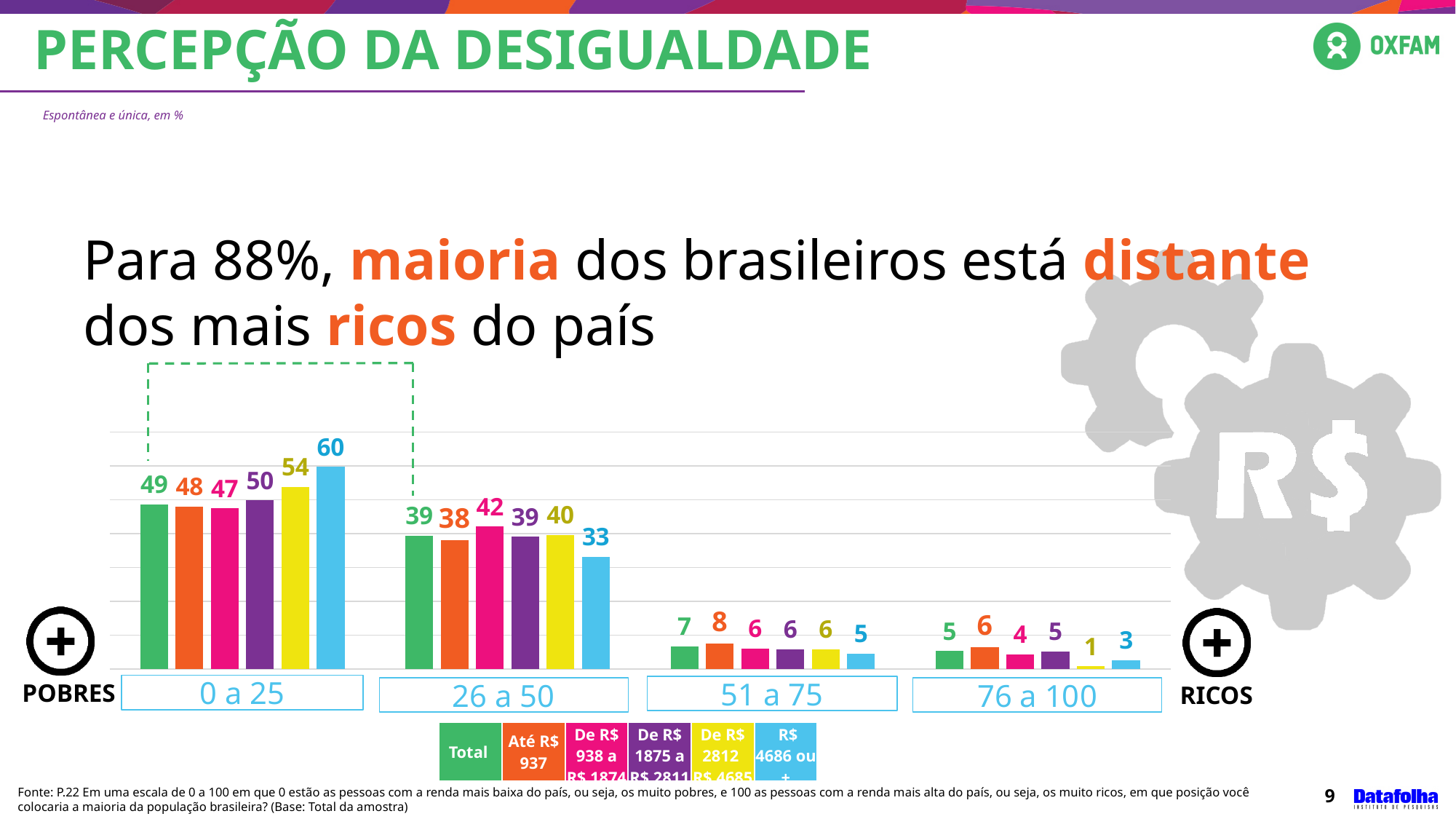
How many categories are shown on the x axis? 4 Which category has the highest Total value? 0 a 25 What is the difference between the Total values for "0 a 25" and "26 a 50"? 10 What is the Total value for the "0 a 25" category? 49 What is the value for the "Até R$ 937" series in the "51 a 75" category? 8 What is the Total value for the "26 a 50" category? 39 Which category has the lowest Total value? 76 a 100 What kind of chart is shown on the slide? Bar chart Do the Total values rise or fall from "0 a 25" to "76 a 100"? Fall What is the value for the "R$ 4686 ou +" series in the "0 a 25" category? 60 In the "26 a 50" category, which is larger: the "Até R$ 937" value or the "R$ 4686 ou +" value? Até R$ 937 How many series does the legend list? 6